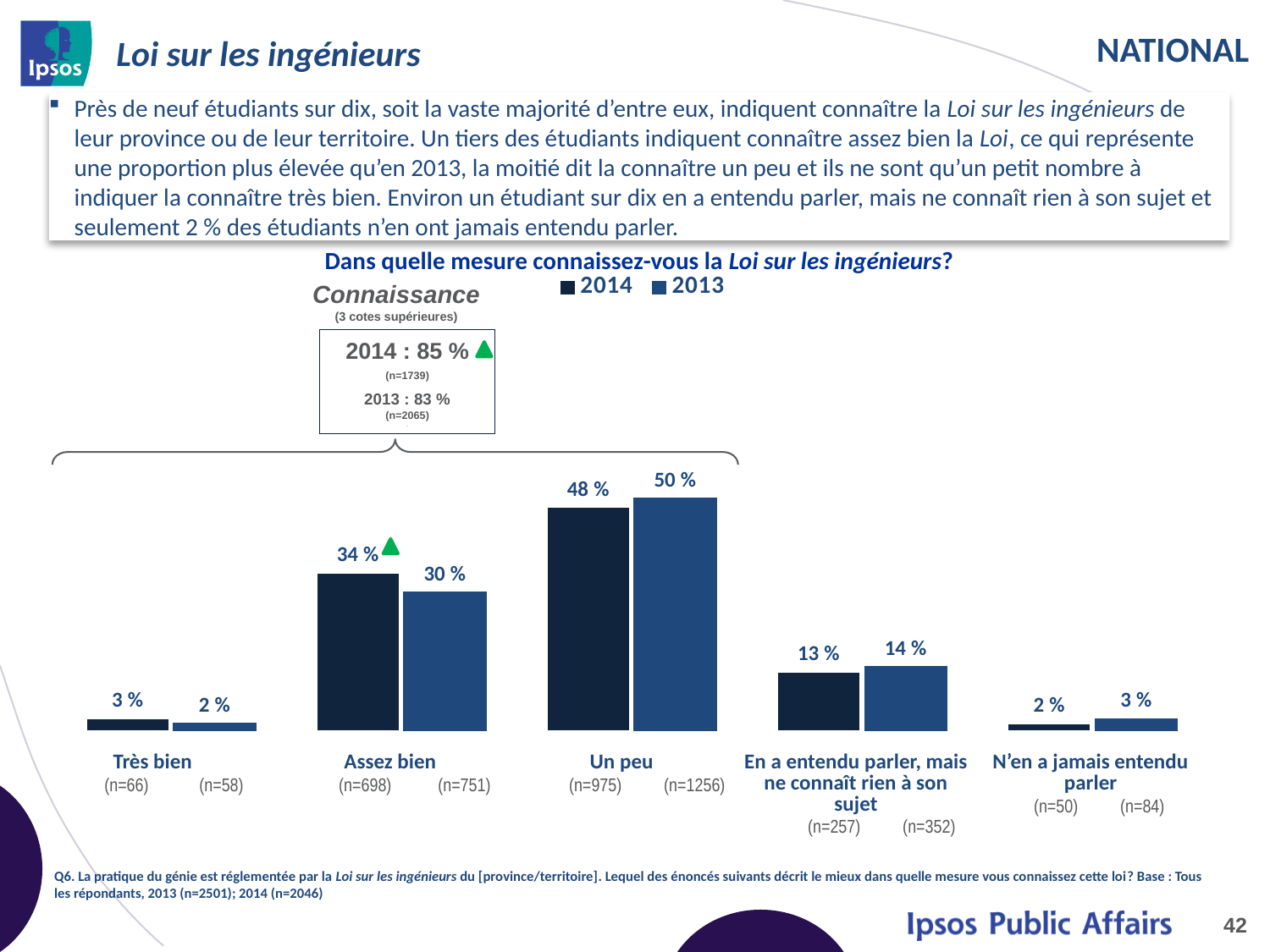
For "Un peu", which year has the larger value, 2014 or 2013? 2013 What are the two series named in the chart legend? 2014 and 2013 What is the 2014 value for "Assez bien"? 34 % What is the 2014 value for "En a entendu parler, mais ne connaît rien à son sujet"? 13 % What is the difference between the 2014 and 2013 values for "Assez bien"? 4 % What kind of chart is shown on the slide? Bar chart Which category has the highest 2014 value? Un peu What is the 2013 value for "N'en a jamais entendu parler"? 3 % Which category has the lowest 2013 value? Très bien How many series does the chart legend list? 2 What is the 2013 value for "Un peu"? 50 % How many categories are shown on the x axis of the chart? 5